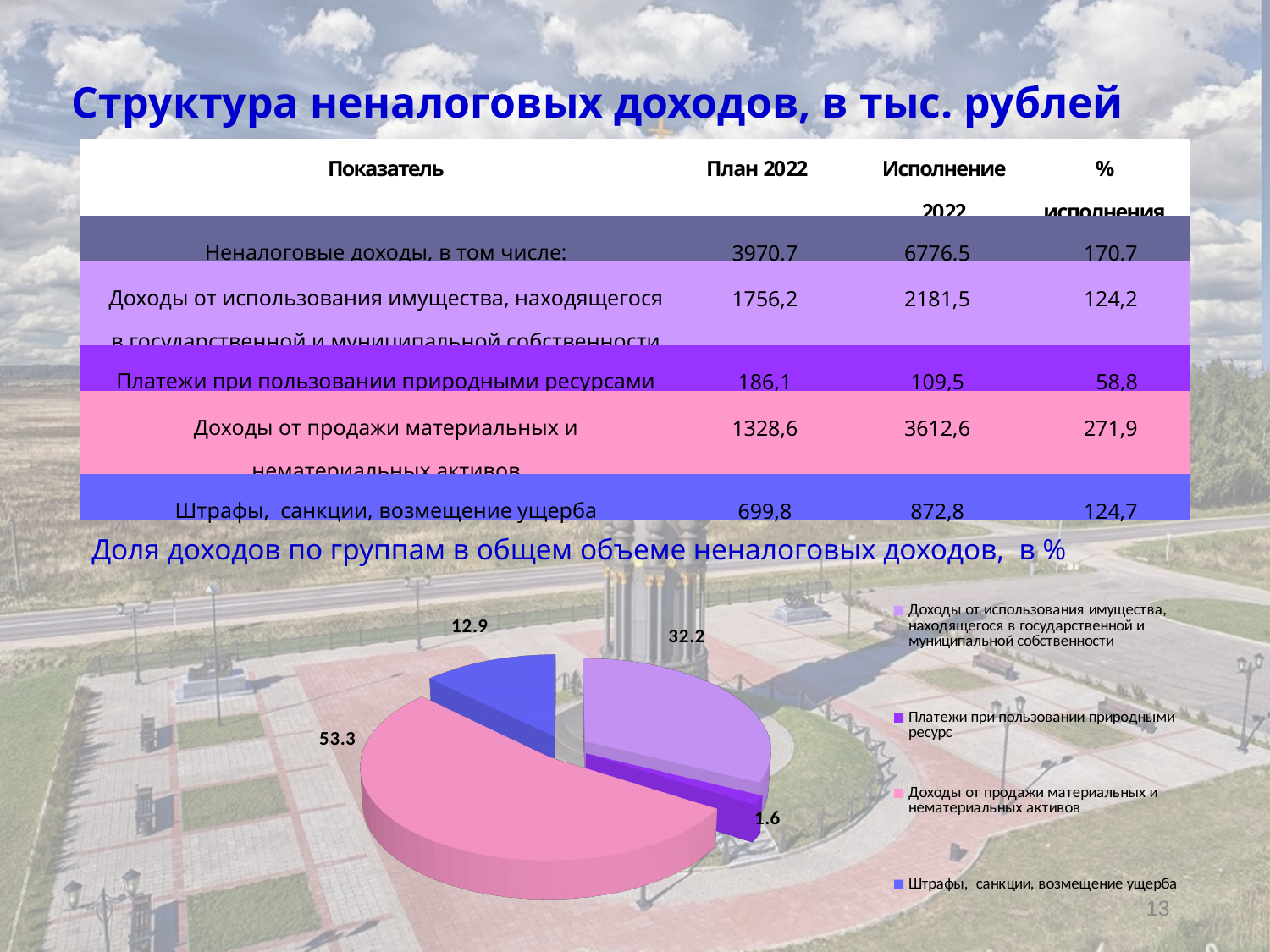
What is the title of the pie chart? Доля доходов по группам в общем объеме неналоговых доходов, в % What is the difference between the shares for "Доходы от продажи материальных и нематериальных активов" and "Доходы от использования имущества, находящегося в государственной и муниципальной собственности"? 21.1 Which category has the largest slice in the pie chart? Доходы от продажи материальных и нематериальных активов How many slices does the pie chart have? 4 What kind of chart is shown on the slide? pie chart What is the share for "Штрафы, санкции, возмещение ущерба" in the pie chart? 12.9 What colour is the slice for "Доходы от продажи материальных и нематериальных активов" in the pie chart? pink Which category has the smallest slice in the pie chart? Платежи при пользовании природными ресурс What is the share for "Доходы от продажи материальных и нематериальных активов" in the pie chart? 53.3 Which is larger in the pie chart: the share for "Штрафы, санкции, возмещение ущерба" or the share for "Платежи при пользовании природными ресурс"? Штрафы, санкции, возмещение ущерба What is the share for "Доходы от использования имущества, находящегося в государственной и муниципальной собственности" in the pie chart? 32.2 What is the share for "Платежи при пользовании природными ресурс" in the pie chart? 1.6